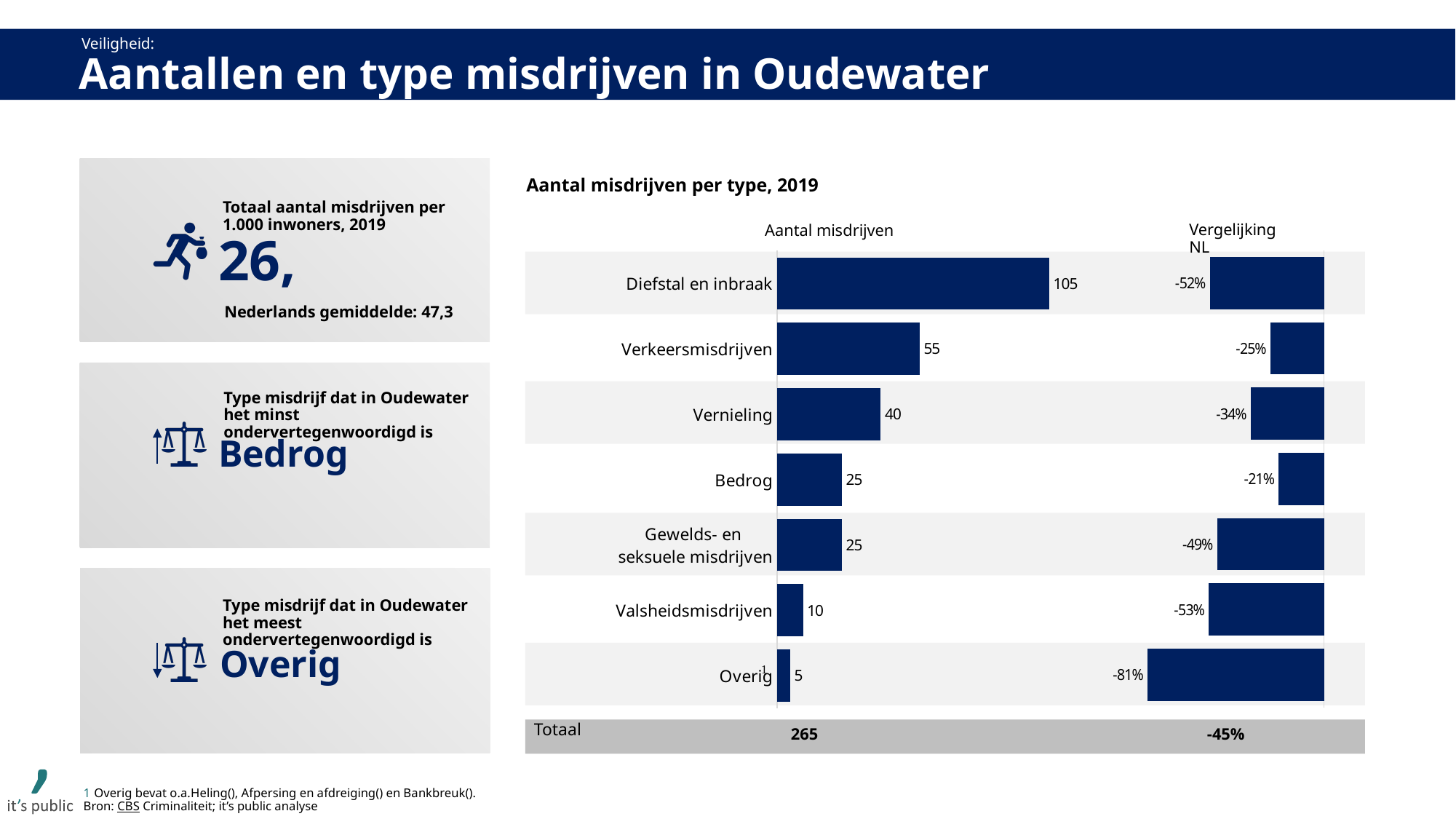
In the chart 'Aantal misdrijven per type, 2019', which crime type has the lowest 'Aantal misdrijven'? Overig What kind of chart is 'Aantal misdrijven per type, 2019'? Bar chart In the chart 'Aantal misdrijven per type, 2019', how many crime types are shown (excluding the Totaal row)? 7 In the chart 'Aantal misdrijven per type, 2019', what is the 'Vergelijking NL' value for Verkeersmisdrijven? -25% In the chart 'Aantal misdrijven per type, 2019', what is the difference in 'Aantal misdrijven' between Diefstal en inbraak and Verkeersmisdrijven? 50 In the chart 'Aantal misdrijven per type, 2019', what is the 'Aantal misdrijven' value for Diefstal en inbraak? 105 In the chart 'Aantal misdrijven per type, 2019', what is the 'Aantal misdrijven' value for Valsheidsmisdrijven? 10 In the chart 'Aantal misdrijven per type, 2019', what are the two column headings above the bars? Aantal misdrijven and Vergelijking NL In the chart 'Aantal misdrijven per type, 2019', what is the Totaal 'Aantal misdrijven'? 265 In the chart 'Aantal misdrijven per type, 2019', which crime type has the highest 'Aantal misdrijven'? Diefstal en inbraak In the chart 'Aantal misdrijven per type, 2019', what is the 'Vergelijking NL' value for Overig? -81% In the chart 'Aantal misdrijven per type, 2019', which has a higher 'Aantal misdrijven': Vernieling or Bedrog? Vernieling